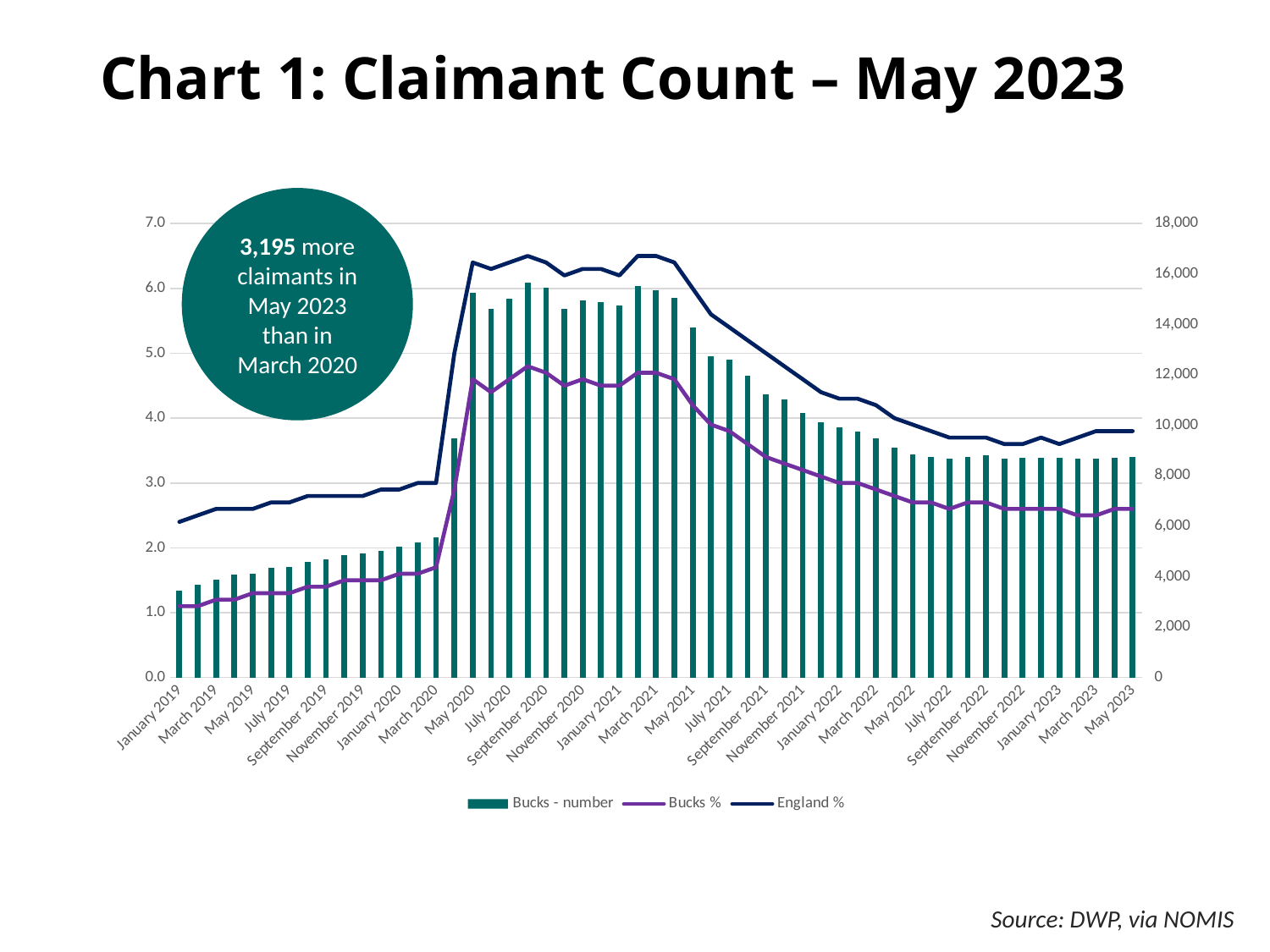
Which is higher in May 2023, the England % line or the Bucks % line? England % Is the England % value for May 2020 greater or less than 6.0? greater Which is larger, the Bucks - number bar for May 2023 or the bar for March 2020? May 2023 Is the Bucks - number value for January 2019 greater or less than 4,000? less According to the callout, how many more claimants were there in May 2023 than in March 2020? 3,195 What kind of chart is shown on the slide? A combined bar and line chart Is the Bucks - number value for May 2023 greater or less than 10,000? less Do the Bucks - number bars rise or fall between May 2021 and May 2022? fall How many series does the legend list? 3 What source is cited for the chart? DWP, via NOMIS Which series is plotted as bars? Bucks - number